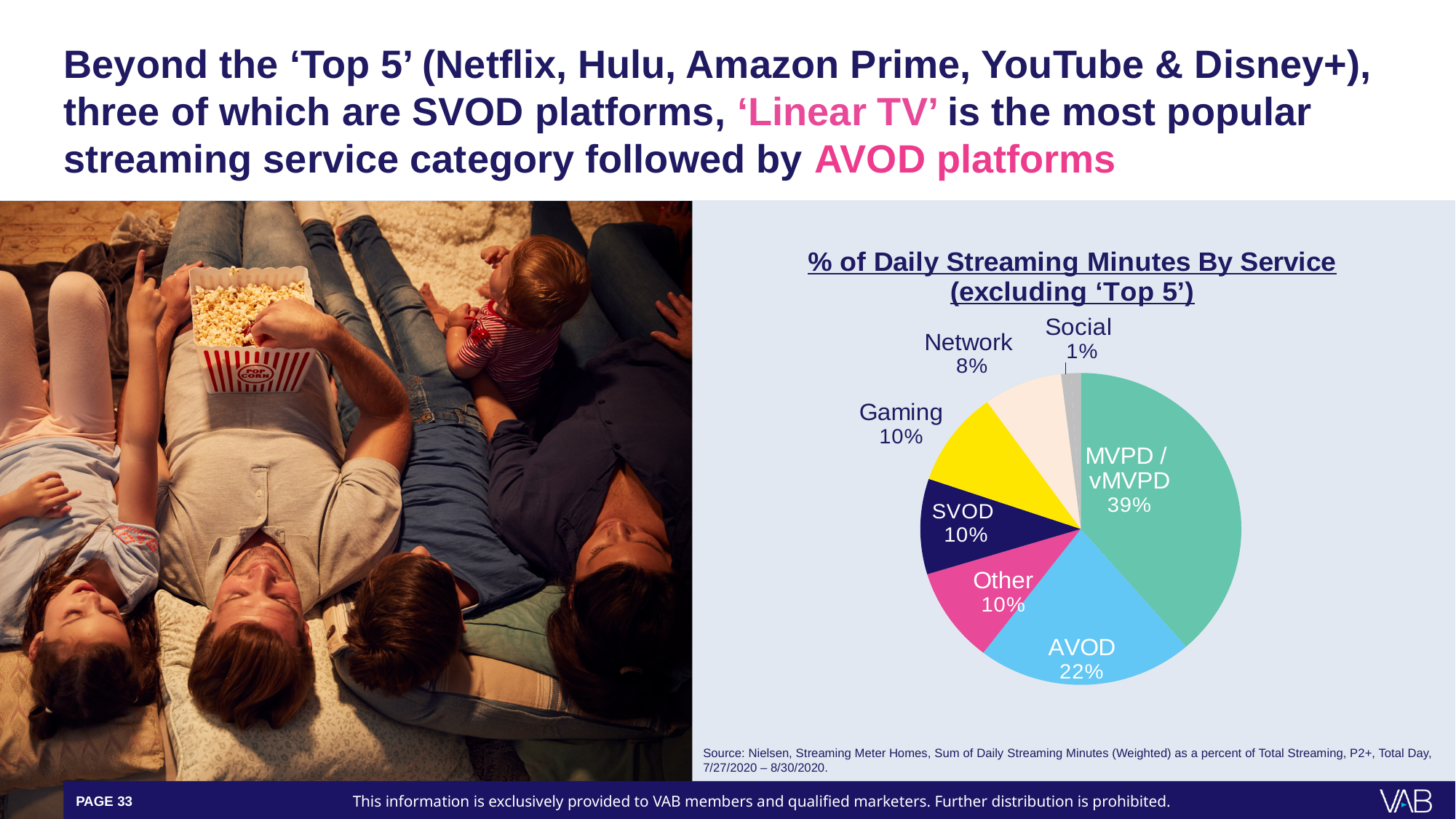
Which has a larger share, Gaming or Network? Gaming What is the difference in share between MVPD / vMVPD and AVOD? 17% What share of daily streaming minutes does AVOD account for? 22% What share of daily streaming minutes does Network account for? 8% Which category has the largest share of daily streaming minutes? MVPD / vMVPD What kind of chart is shown on the slide? Pie chart What is the title of the chart? % of Daily Streaming Minutes By Service (excluding 'Top 5') How many categories are shown in the pie chart? 8 What share of daily streaming minutes does MVPD / vMVPD account for? 39% What share of daily streaming minutes does Social account for? 1% What is the combined share of SVOD, Gaming and Other? 30%